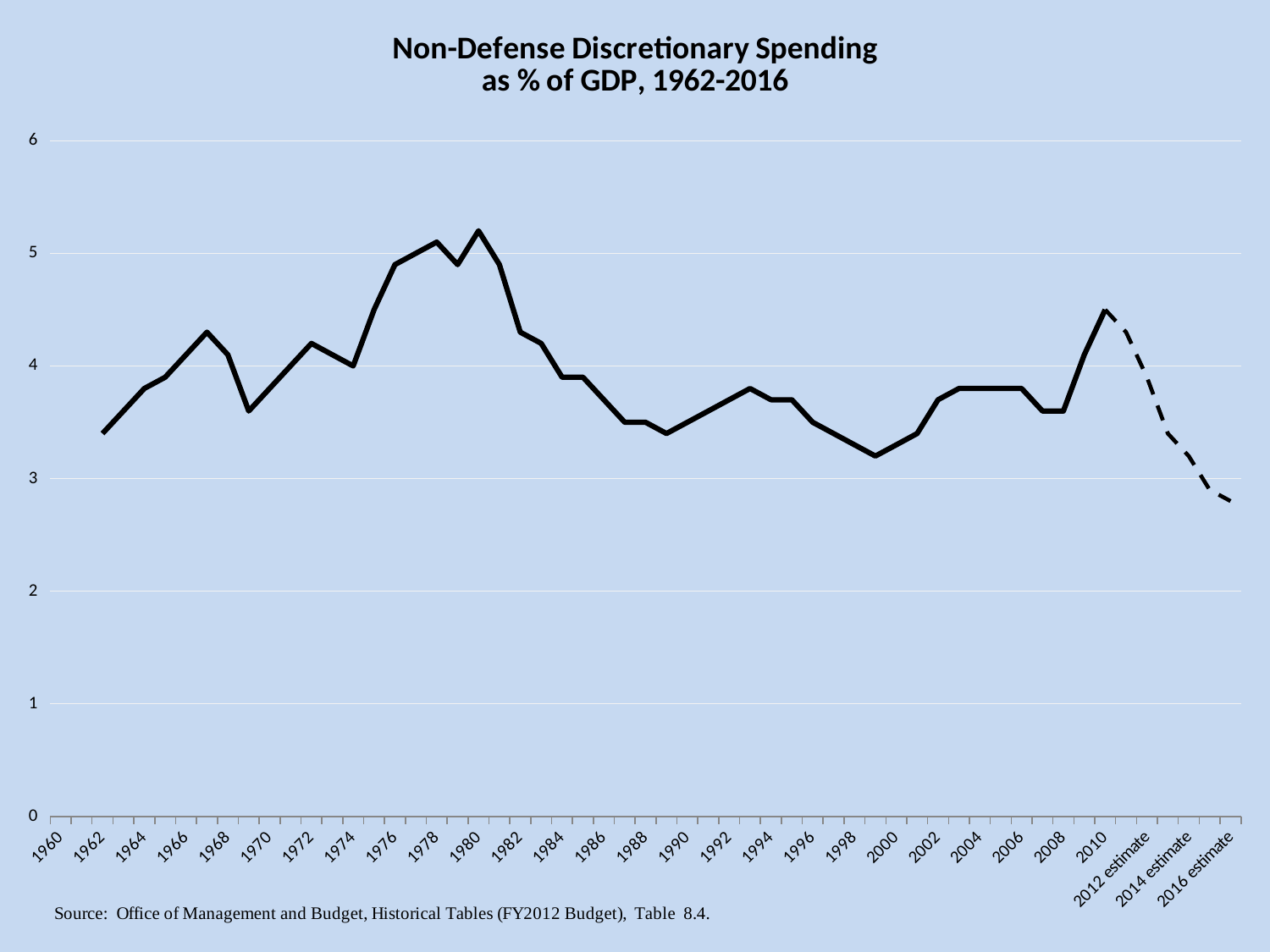
Does the line rise or fall from 2010 to the 2016 estimate? fall Does the line rise or fall from 1980 to 1990? fall In which year does the line reach its highest value? 1980 Is the value for 1967 greater or less than 4? greater What is the title of the chart? Non-Defense Discretionary Spending as % of GDP, 1962-2016 Which is larger, the value for 2010 or the value for 2000? 2010 Which is larger, the value for 1976 or the value for 1990? 1976 Is the value for 1962 greater or less than 4? less Which point on the x axis has the lowest value? 2016 estimate What kind of chart is shown on the slide? line chart Is the value for 1980 greater or less than 5? greater